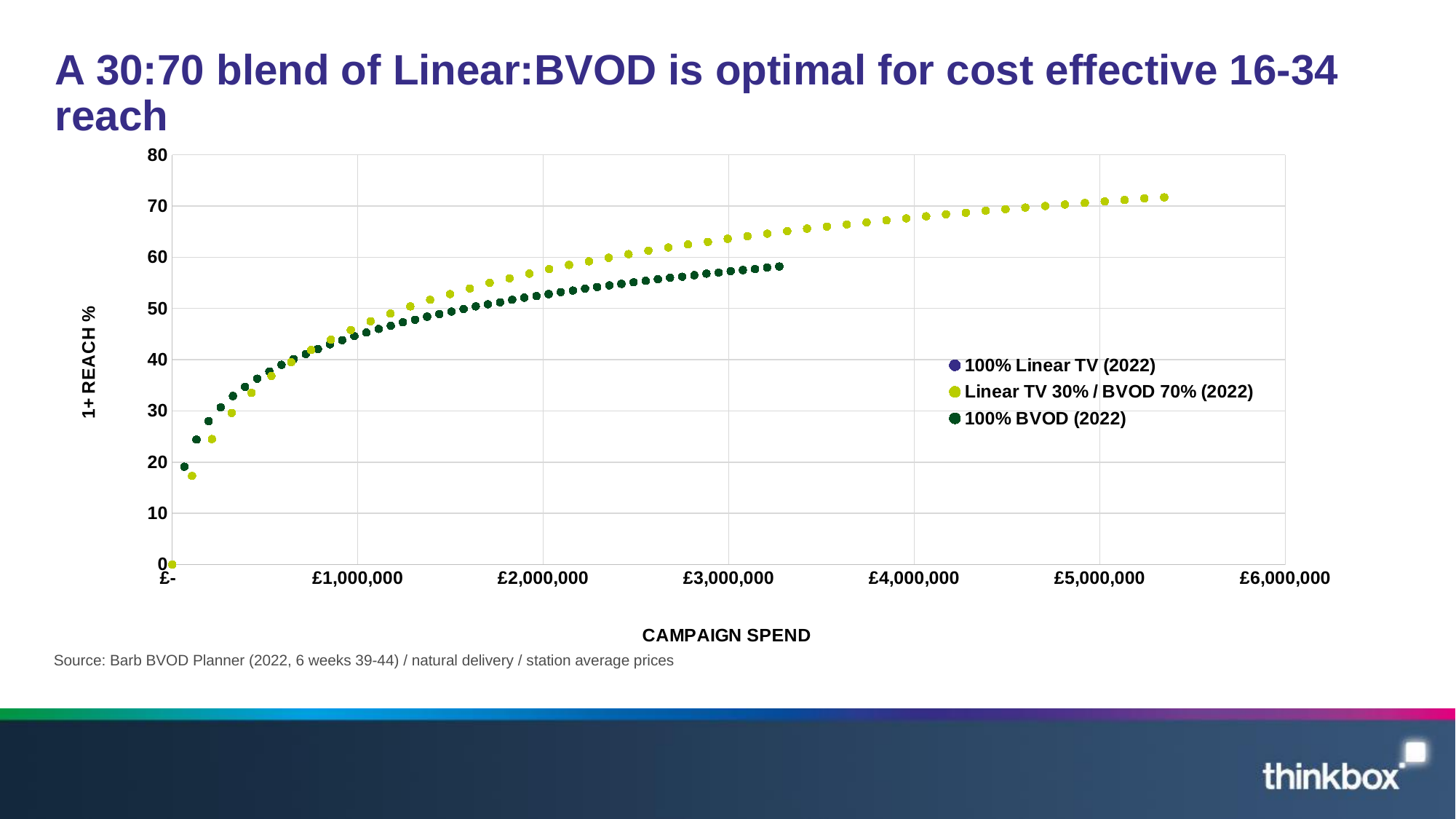
What is the label of the chart's vertical axis? 1+ REACH % What is the label of the chart's horizontal axis? CAMPAIGN SPEND Is the 1+ reach % for 100% BVOD (2022) at a campaign spend of £3,000,000 greater or less than 60? less At a campaign spend of £2,000,000, which series has the higher 1+ reach %: Linear TV 30% / BVOD 70% (2022) or 100% BVOD (2022)? Linear TV 30% / BVOD 70% (2022) Is the 1+ reach % for 100% BVOD (2022) at a campaign spend of £2,000,000 greater or less than 50? greater As campaign spend increases, does 1+ reach % for the Linear TV 30% / BVOD 70% (2022) series rise or fall? Rise What kind of chart is shown on the slide? Scatter chart Is the 1+ reach % for Linear TV 30% / BVOD 70% (2022) at a campaign spend of £4,000,000 greater or less than 60? greater How many series does the chart legend list? 3 Which plotted series extends to the highest campaign spend on the chart? Linear TV 30% / BVOD 70% (2022) Which plotted series reaches the highest 1+ reach % on the chart? Linear TV 30% / BVOD 70% (2022)